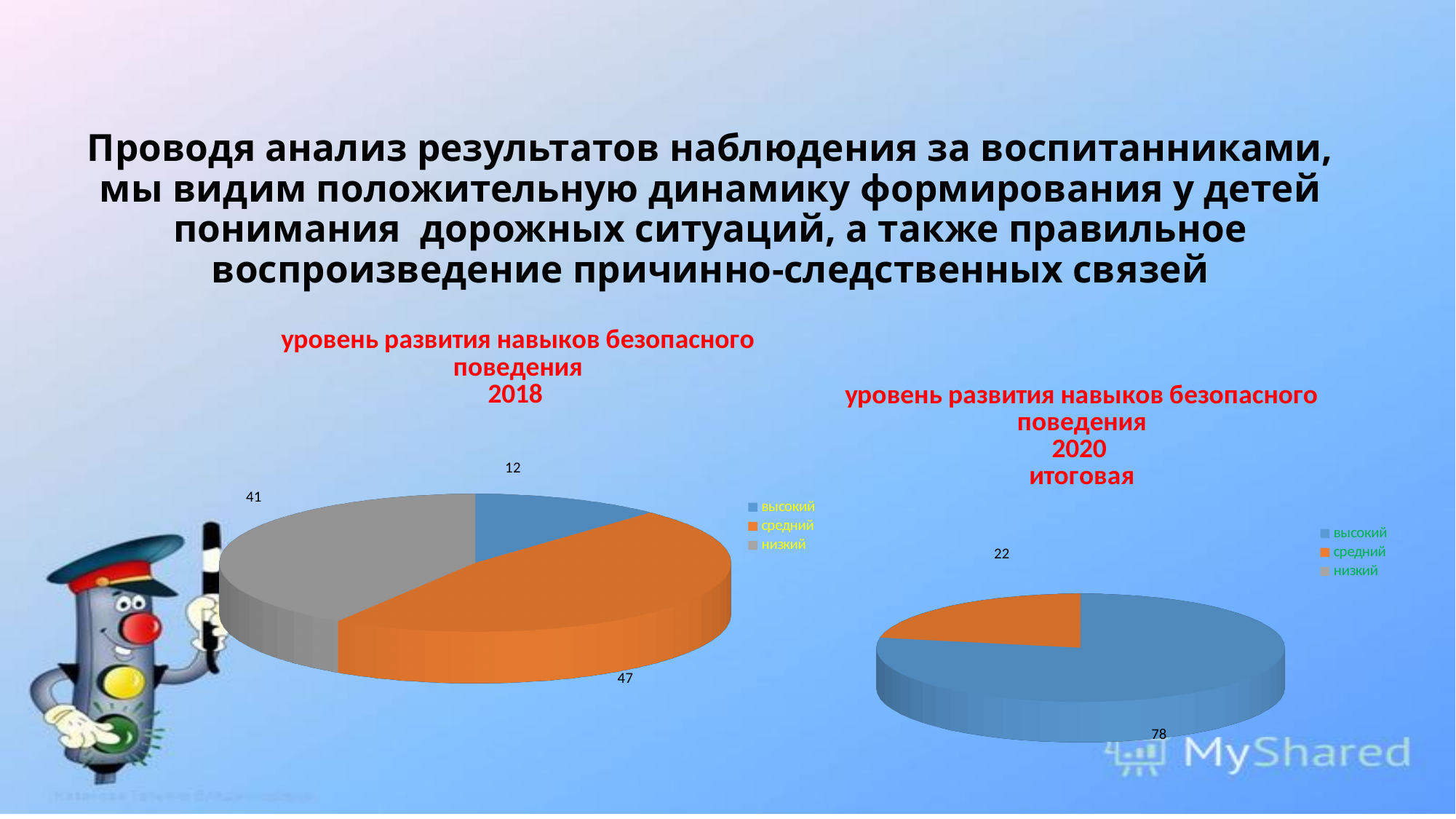
How many entries does the legend of the 2018 chart list? 3 In the 2020 итоговая chart, which is larger, высокий or средний? высокий In the 2018 chart, which category has the largest slice? средний In the 2018 chart, which category has the smallest slice? высокий In the 2018 chart, what is the difference between средний and низкий? 6 In the 2018 chart, what is the value for средний? 47 In the 2020 итоговая chart, what is the value for средний? 22 In the 2018 chart, what is the value for низкий? 41 In the 2020 итоговая chart, what is the difference between высокий and средний? 56 What type of chart is used on the left (2018) chart? pie chart In the 2018 chart, what is the value for высокий? 12 In the 2020 итоговая chart, what is the value for высокий? 78